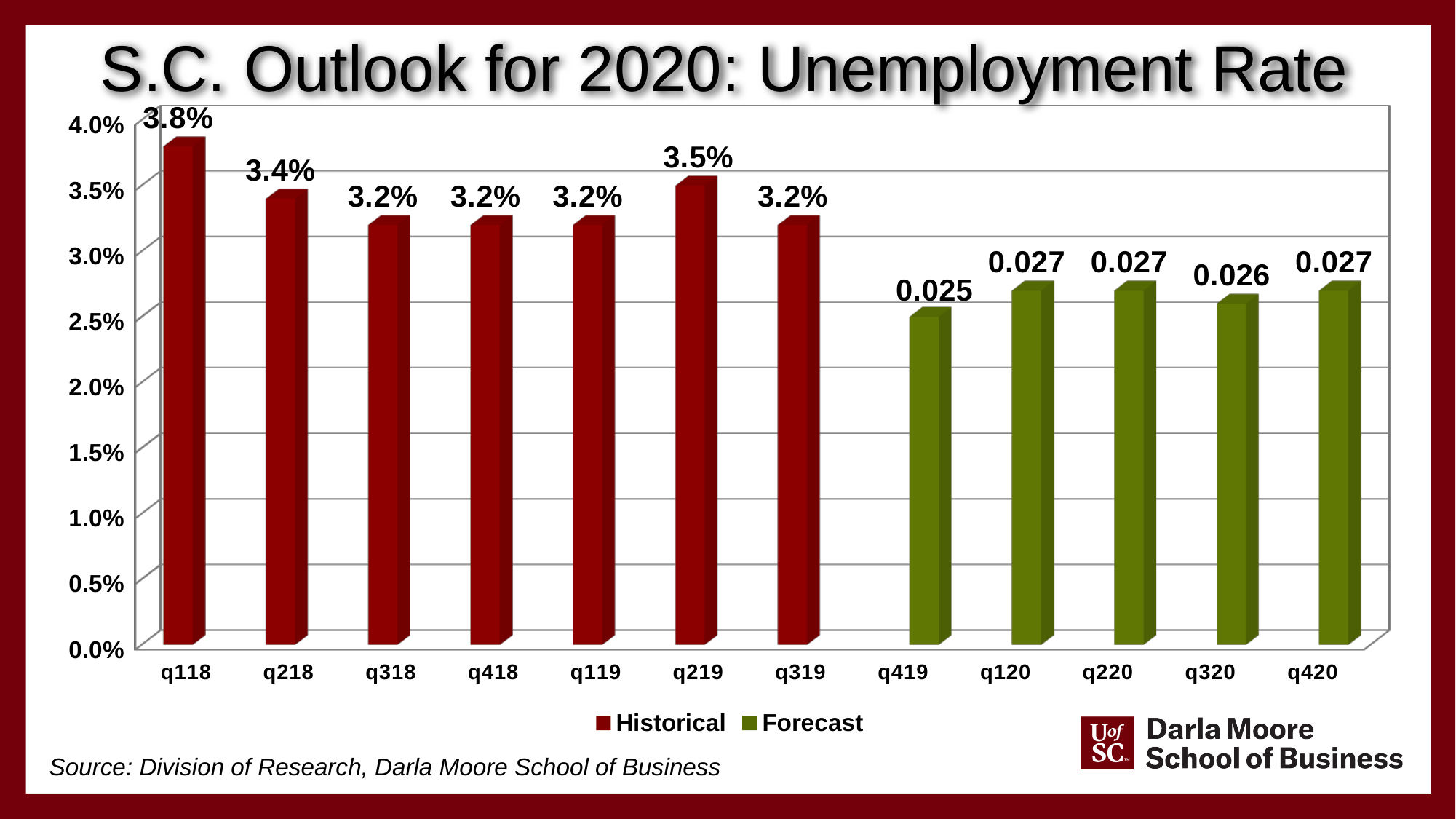
What kind of chart is shown on the slide? Bar chart What colour are the Forecast bars? Green How many series does the legend list? 2 What value is labelled on the bar for q320? 0.026 Which quarter has the highest unemployment rate on the chart? q118 Which is larger, the value for q218 or the value for q318? q218 What is the difference between the values for q118 and q218? 0.4% Which quarter has the lowest value on the chart? q419 What value is labelled on the bar for q219? 3.5% What is the unemployment rate shown for q118? 3.8% What value is labelled on the forecast bar for q419? 0.025 How many quarters are shown on the x axis? 12